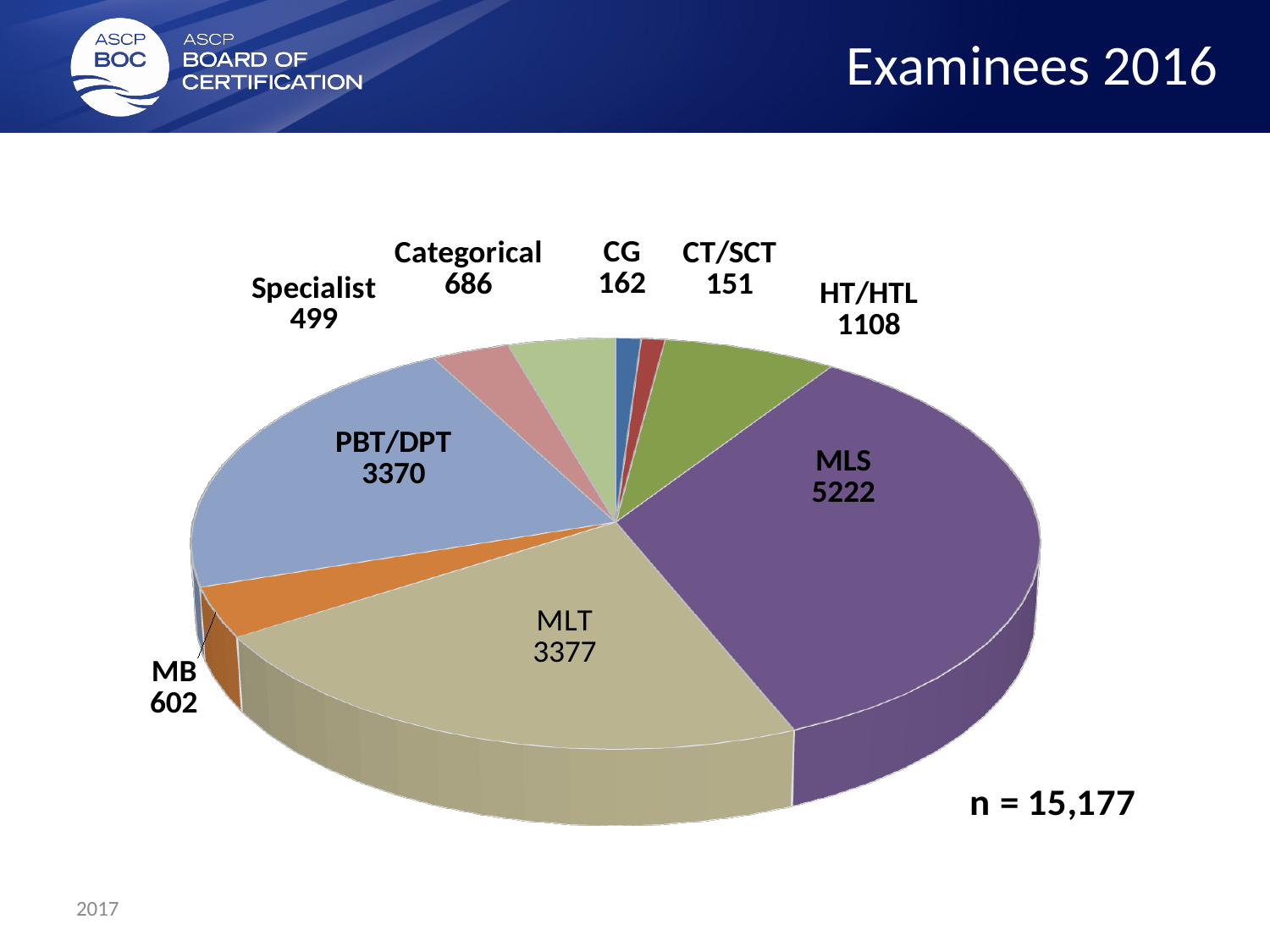
What is the value shown for PBT/DPT? 3370 Which category has the smallest number of examinees? CT/SCT What is the value shown for CT/SCT? 151 What is the title of the chart? Examinees 2016 How many categories are shown in the pie chart? 9 Which has more examinees, MLT or PBT/DPT? MLT What is the difference between the MLS and MLT values? 1845 What type of chart is shown on the slide? Pie chart Which category has the largest number of examinees? MLS How many examinees are in the MLS category? 5222 What is the value shown for HT/HTL? 1108 What is the total number of examinees (n) shown on the slide? 15,177